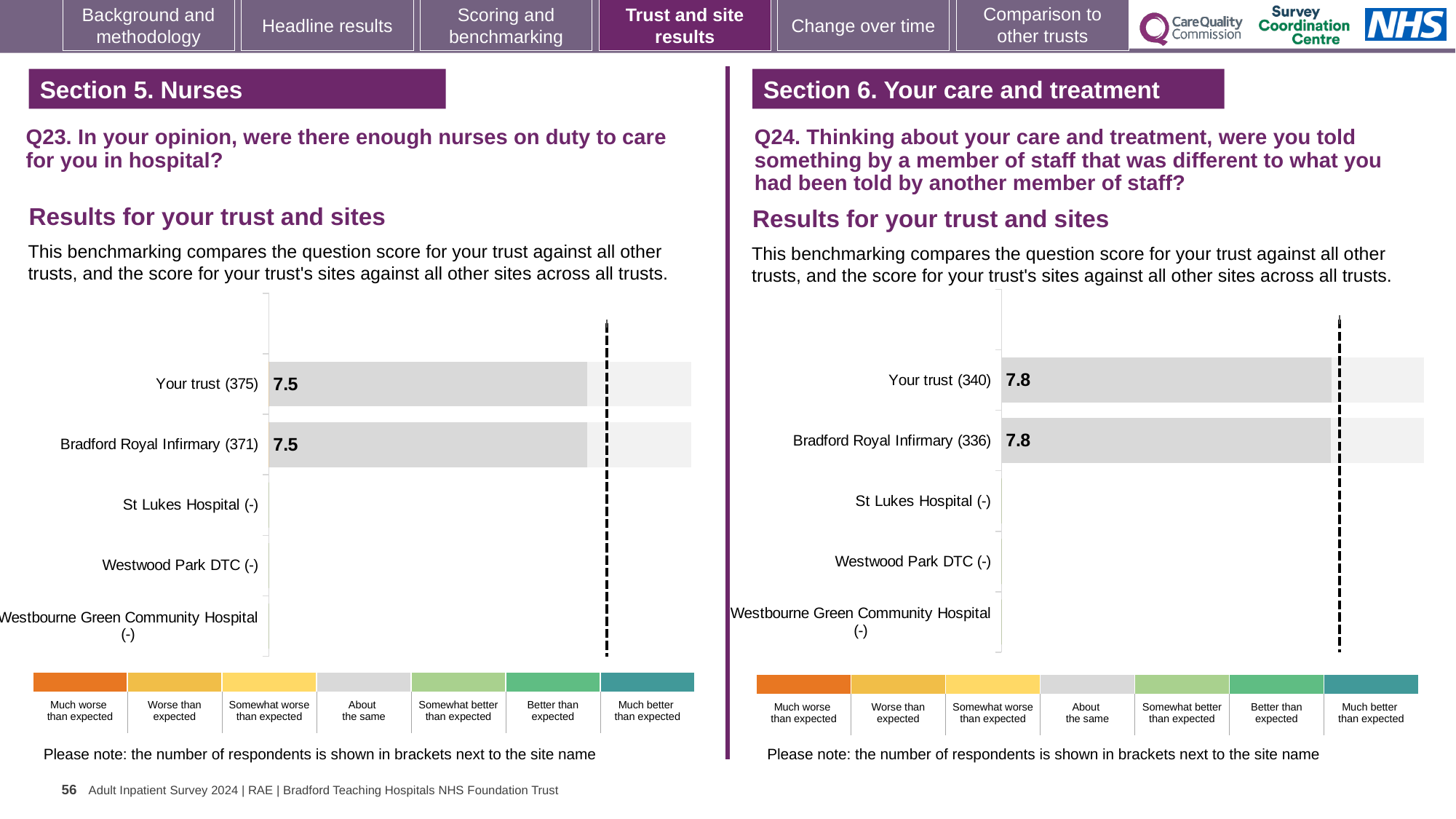
In the Q24 chart on the right, what is the difference between the score for Your trust and the score for Bradford Royal Infirmary? 0 In the Q23 chart on the left, how many respondents are shown in brackets for Your trust? 375 How many site or trust categories are listed on the y axis of the Q24 chart on the right? 5 What kind of chart is used for the Q23 results on the left? Bar chart Is the score for Your trust in the Q24 chart on the right larger or smaller than the score for Your trust in the Q23 chart on the left? Larger In the Q24 chart on the right, how many respondents are shown in brackets for Bradford Royal Infirmary? 336 In the Q24 chart on the right, what is the score for Your trust? 7.8 In the Q23 chart on the left, what is the difference between the score for Your trust and the score for Bradford Royal Infirmary? 0 How many site or trust categories are listed on the y axis of the Q23 chart on the left? 5 In the Q24 chart on the right, what is the score for Bradford Royal Infirmary? 7.8 In the Q23 chart on the left, what is the score for Your trust? 7.5 In the Q23 chart on the left, what is the score for Bradford Royal Infirmary? 7.5